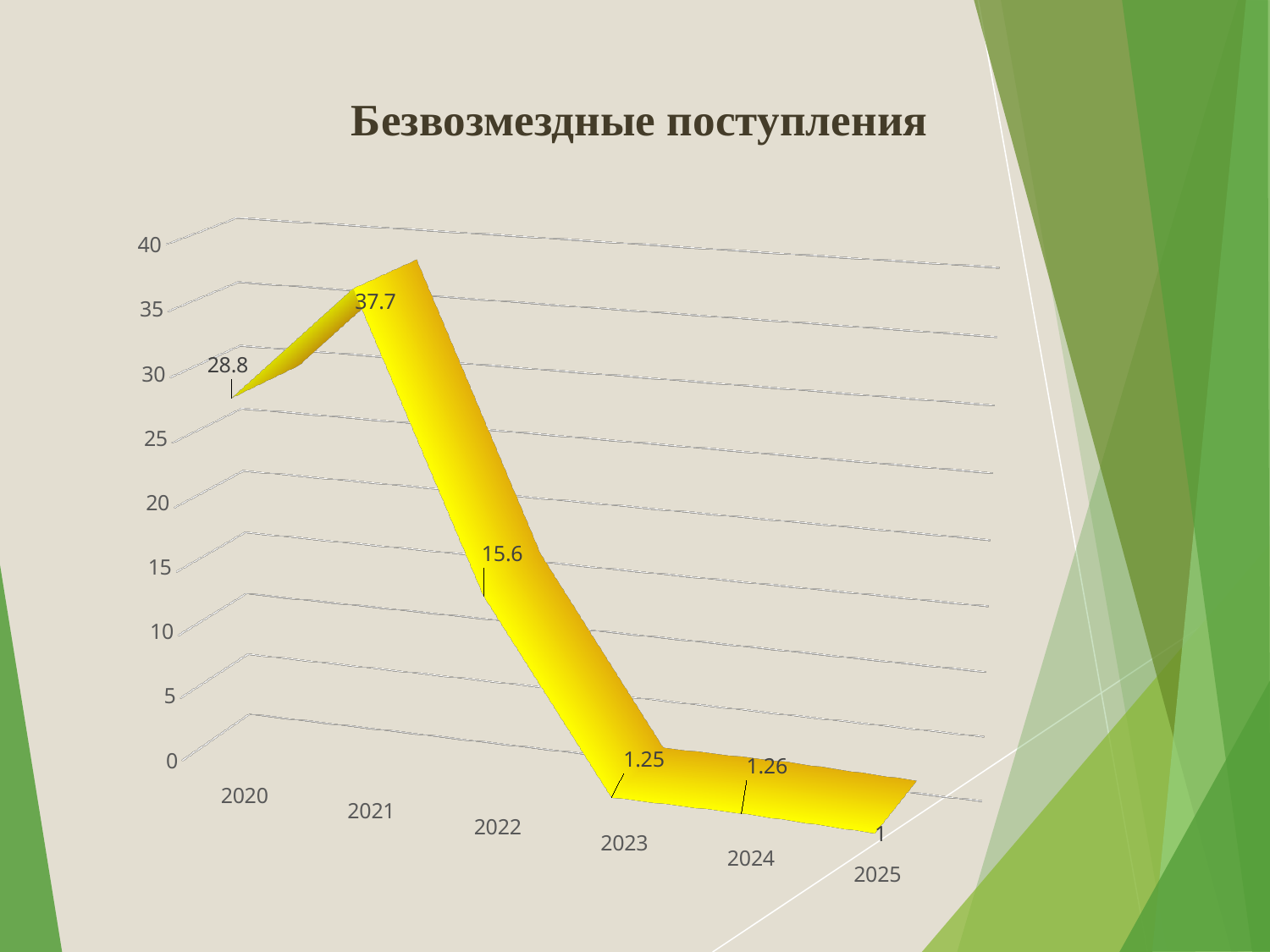
What is the value for 2025? 1 What is the difference between the values for 2021 and 2020? 8.9 Which is larger, the value for 2020 or the value for 2022? 2020 How many years are shown on the x axis? 6 What kind of chart is this? line chart What is the value for 2020? 28.8 Which year has the highest value? 2021 What is the value for 2022? 15.6 Which year has the lowest value? 2025 What is the title of the chart? Безвозмездные поступления What is the difference between the values for 2022 and 2023? 14.35 What is the value for 2021? 37.7